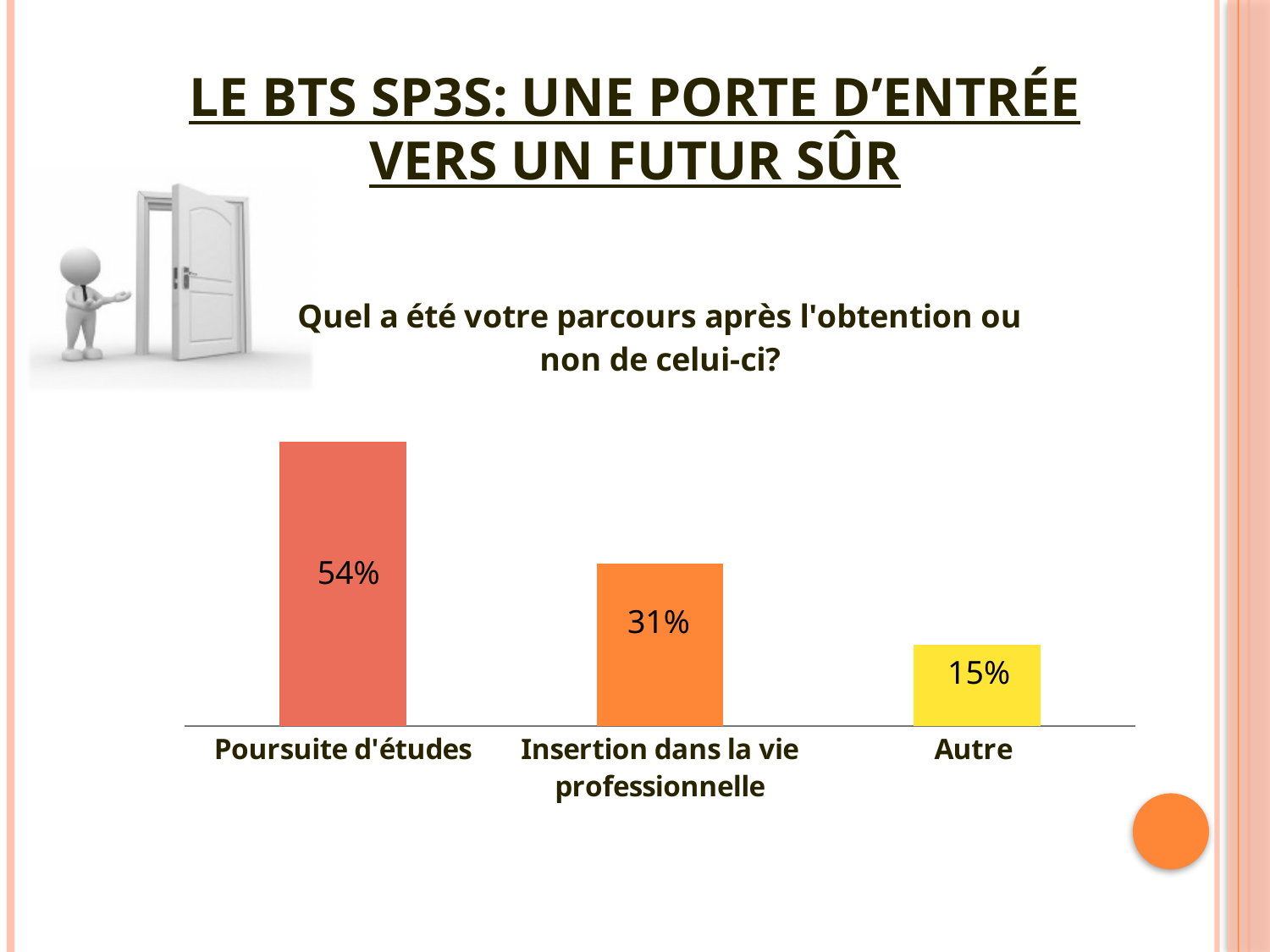
What is the value for Poursuite d'études? 54% What kind of chart is shown on the slide? Bar chart What is the difference between the values for Insertion dans la vie professionnelle and Autre? 16% What is the title of the chart? Quel a été votre parcours après l'obtention ou non de celui-ci? Which is larger, the value for Insertion dans la vie professionnelle or the value for Autre? Insertion dans la vie professionnelle What is the value for Insertion dans la vie professionnelle? 31% How many categories are shown in the chart? 3 Do the values rise or fall from left to right across the categories? Fall What is the difference between the values for Poursuite d'études and Insertion dans la vie professionnelle? 23% Which category has the lowest value? Autre Which category has the highest value? Poursuite d'études What is the value for Autre? 15%